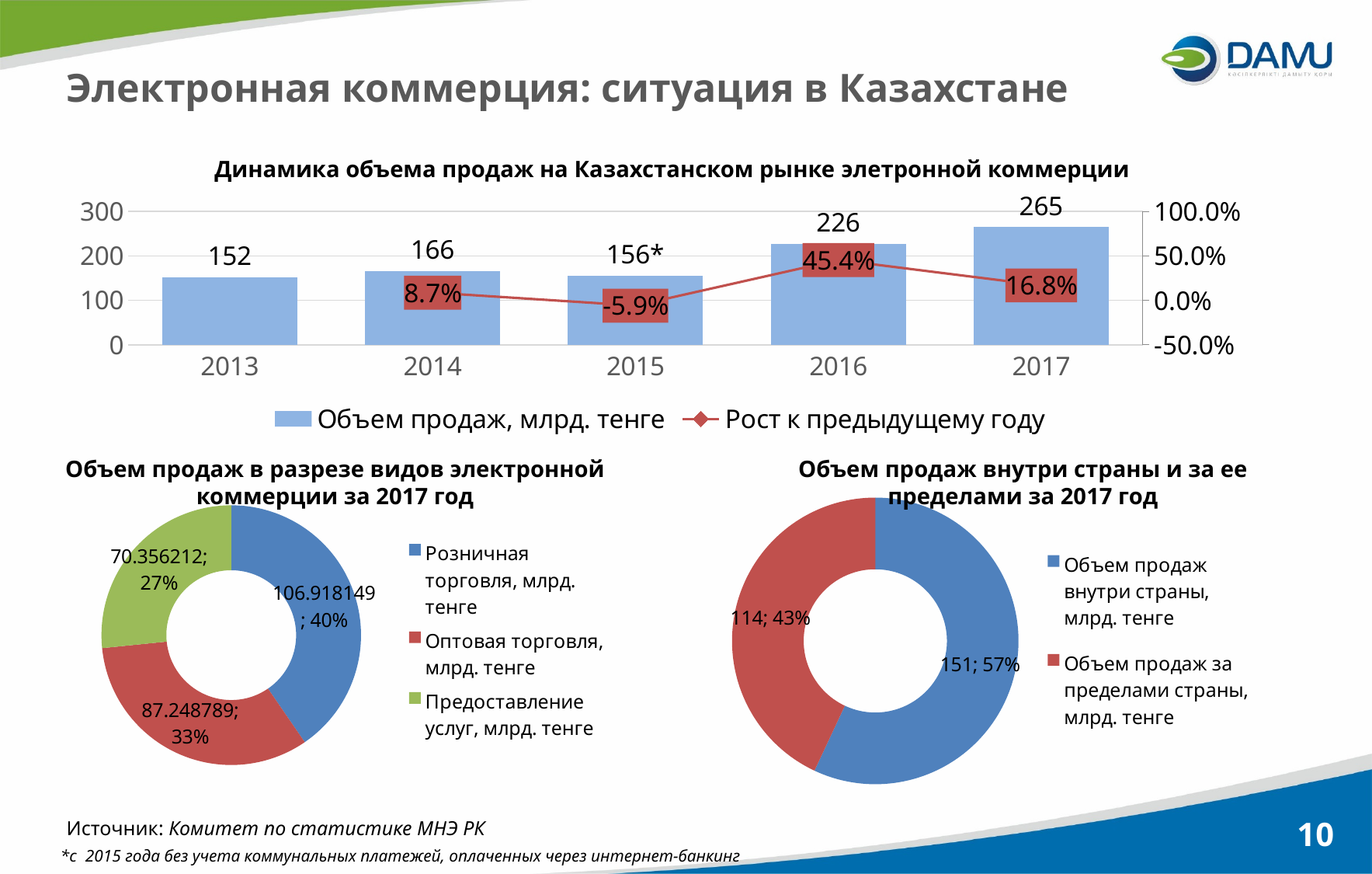
In the chart 'Объем продаж внутри страны и за ее пределами за 2017 год', what is the value for 'Объем продаж за пределами страны, млрд. тенге'? 114 In the chart 'Динамика объема продаж на Казахстанском рынке элетронной коммерции', what is the growth to the previous year (Рост к предыдущему году) for 2016? 45.4% In the chart 'Динамика объема продаж на Казахстанском рынке элетронной коммерции', what is the sales volume (Объем продаж, млрд. тенге) for 2017? 265 In the chart 'Динамика объема продаж на Казахстанском рынке элетронной коммерции', which year has the lowest growth to the previous year? 2015 In the chart 'Динамика объема продаж на Казахстанском рынке элетронной коммерции', which year has the lowest sales volume? 2013 What type of chart is 'Объем продаж внутри страны и за ее пределами за 2017 год'? Doughnut chart How many series does the legend of the chart 'Динамика объема продаж на Казахстанском рынке элетронной коммерции' list? 2 In the chart 'Динамика объема продаж на Казахстанском рынке элетронной коммерции', how many years are shown on the x axis? 5 In the chart 'Объем продаж в разрезе видов электронной коммерции за 2017 год', what is the value for 'Предоставление услуг, млрд. тенге'? 70.356212 In the chart 'Объем продаж в разрезе видов электронной коммерции за 2017 год', what share does 'Оптовая торговля' have? 33% In the chart 'Динамика объема продаж на Казахстанском рынке элетронной коммерции', by how much did the sales volume increase from 2016 to 2017? 39 In the chart 'Объем продаж в разрезе видов электронной коммерции за 2017 год', which category has the largest share? Розничная торговля, млрд. тенге